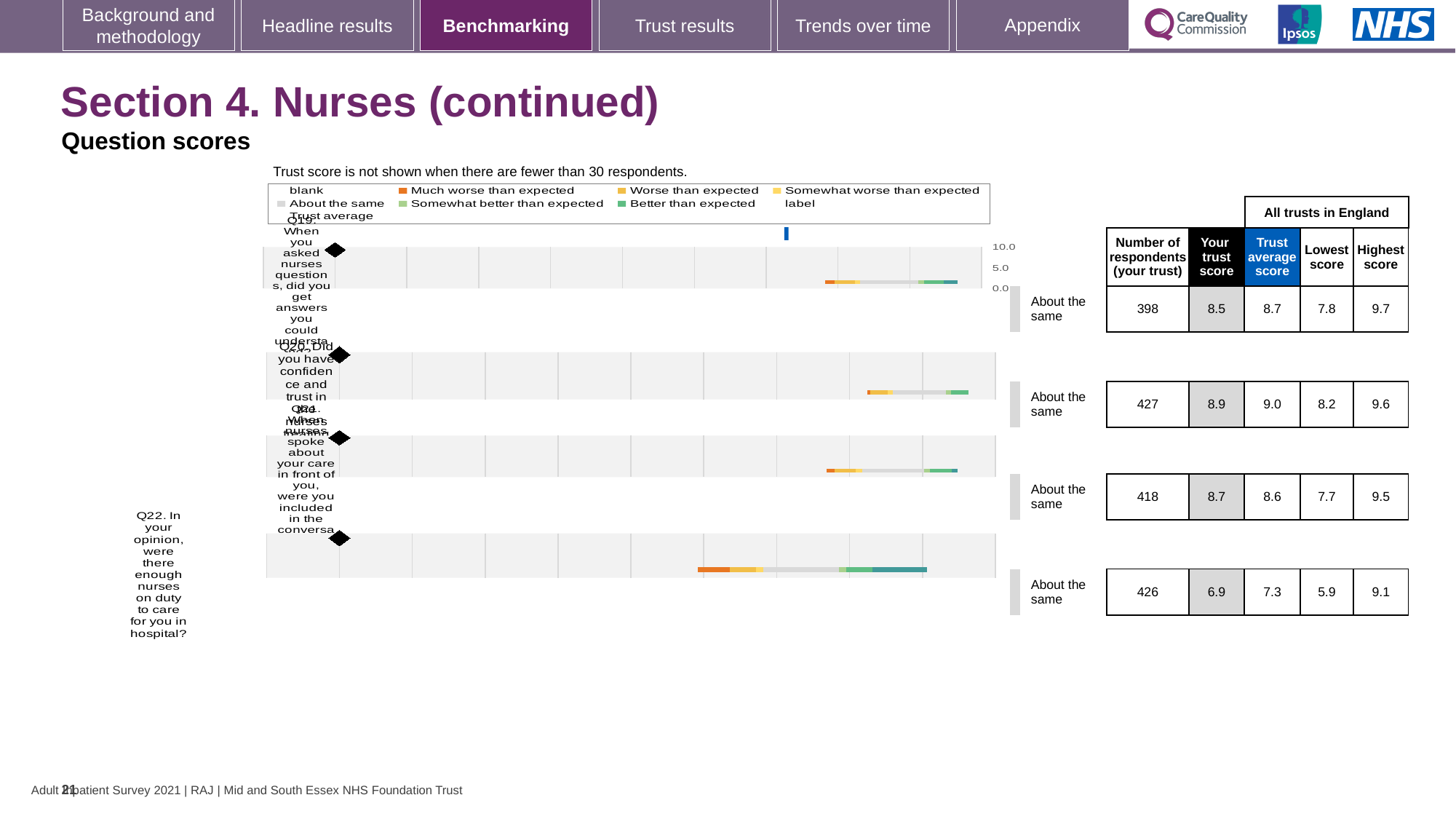
Is your trust score for Q22 greater or less than 5.0 on the chart axis? greater What is the trust average score for Q21? 8.6 What benchmark category is shown for Q22 next to the chart? About the same How many respondents from your trust answered Q20 (did you have confidence and trust in the nurses)? 427 How many questions are plotted on the chart? 4 What is the highest score across all trusts in England for Q19? 9.7 For Q19, which is larger: your trust score or the trust average score? Trust average score What kind of chart is used to show the question scores? Bar chart Which question has the highest 'Your trust score' on this slide? Q20 What is the 'Your trust score' value for Q22 (were there enough nurses on duty to care for you in hospital)? 6.9 What is the difference between the highest score (9.1) and the lowest score (5.9) for Q22? 3.2 Which question has the lowest 'Your trust score' on this slide? Q22